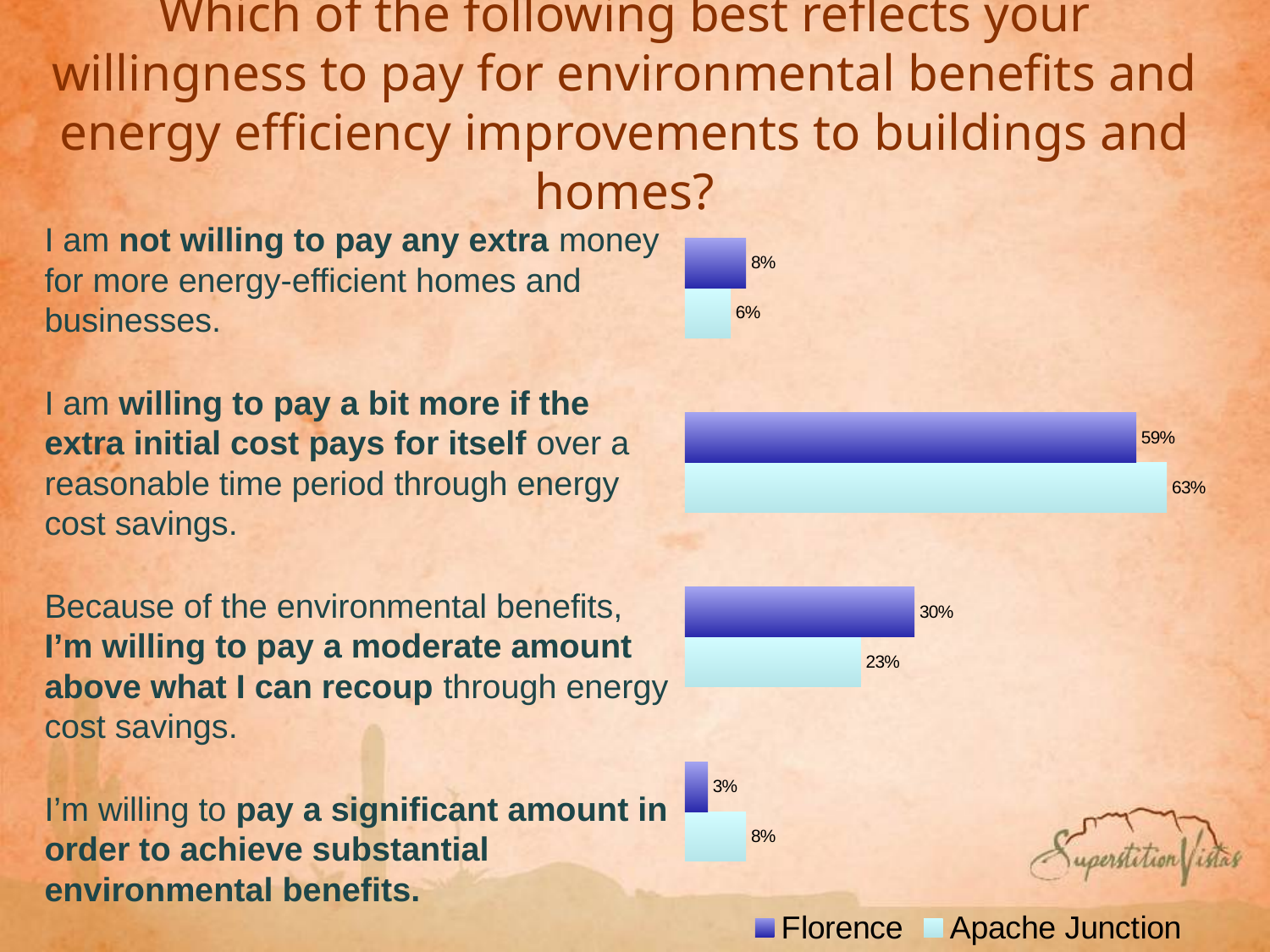
What percentage of Apache Junction respondents are willing to pay a significant amount to achieve substantial environmental benefits? 8% How many series does the legend list? 2 What percentage of Florence respondents are willing to pay a moderate amount above what they can recoup? 30% What kind of chart is shown on the slide? Bar chart For paying a significant amount to achieve substantial environmental benefits, which city has the larger value, Florence or Apache Junction? Apache Junction What is the difference between the Florence and Apache Junction values for being willing to pay a moderate amount above what can be recouped? 7% What percentage of Apache Junction respondents are willing to pay a bit more if the extra initial cost pays for itself? 63% Which response category has the lowest value for Apache Junction? Not willing to pay any extra money What is the difference between the Apache Junction and Florence values for being willing to pay a bit more if the extra initial cost pays for itself? 4% What percentage of Florence respondents are not willing to pay any extra money for more energy-efficient homes and businesses? 8% How many response categories are shown in the chart? 4 Which response category has the highest value for Florence? Willing to pay a bit more if the extra initial cost pays for itself